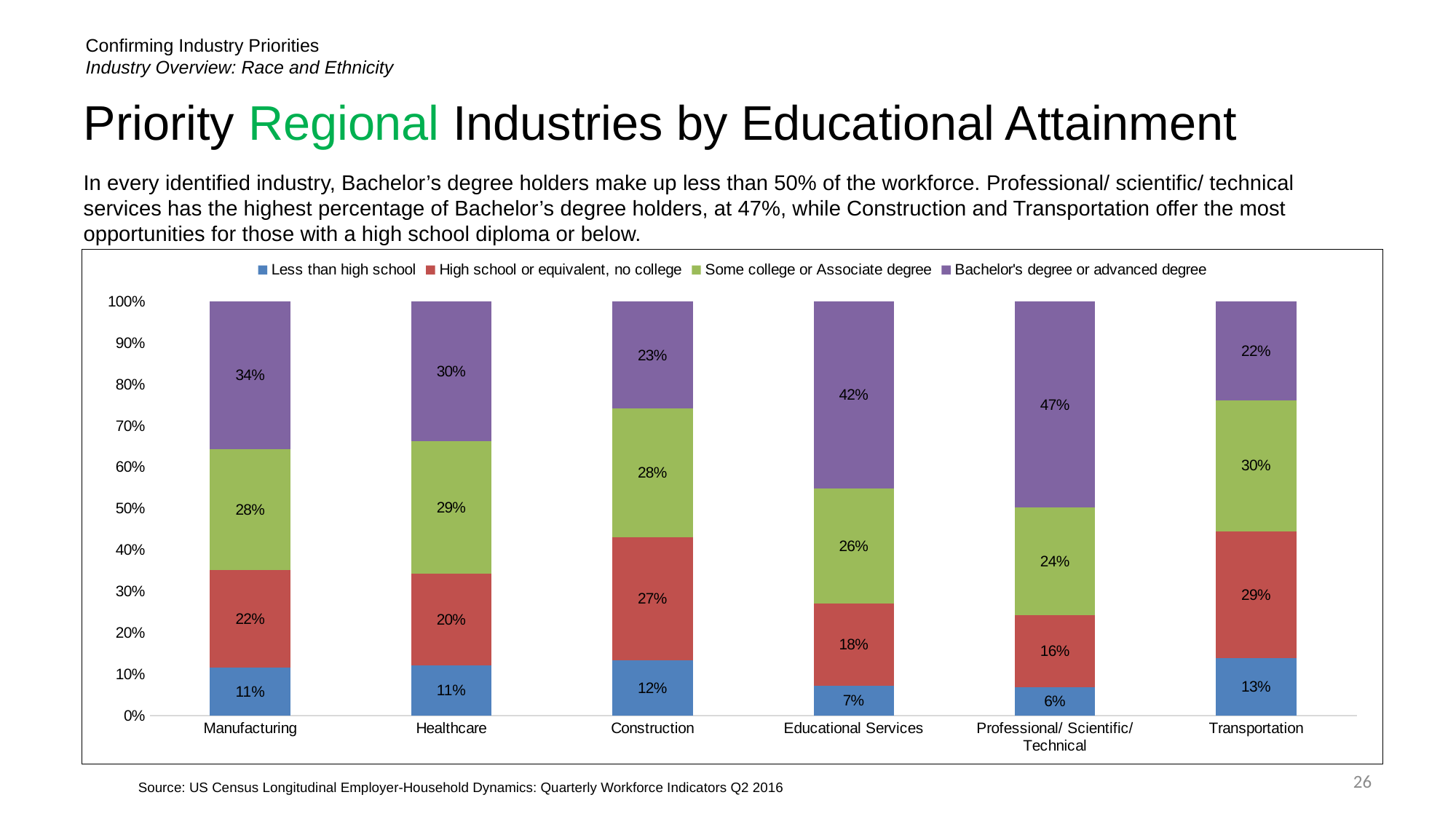
What percentage of the Transportation workforce has less than high school education? 13% Which has a larger share of workers with some college or Associate degree: Healthcare or Professional/ Scientific/ Technical? Healthcare What is the combined share of workers with less than high school and high school or equivalent, no college in Transportation? 42% Which colour represents the 'Some college or Associate degree' series in the chart? Green What percentage of the Manufacturing workforce holds a Bachelor's degree or advanced degree? 34% How many series does the legend list? 4 How many industries are shown on the x axis of the chart? 6 Which industry has the lowest percentage of workers with less than high school education? Professional/ Scientific/ Technical What is the difference between the Bachelor's degree or advanced degree share in Educational Services and in Construction? 19% What kind of chart is shown on the slide? Stacked bar chart What percentage of the Construction workforce has a high school diploma or equivalent, no college? 27% Which industry has the highest percentage of Bachelor's degree or advanced degree holders? Professional/ Scientific/ Technical